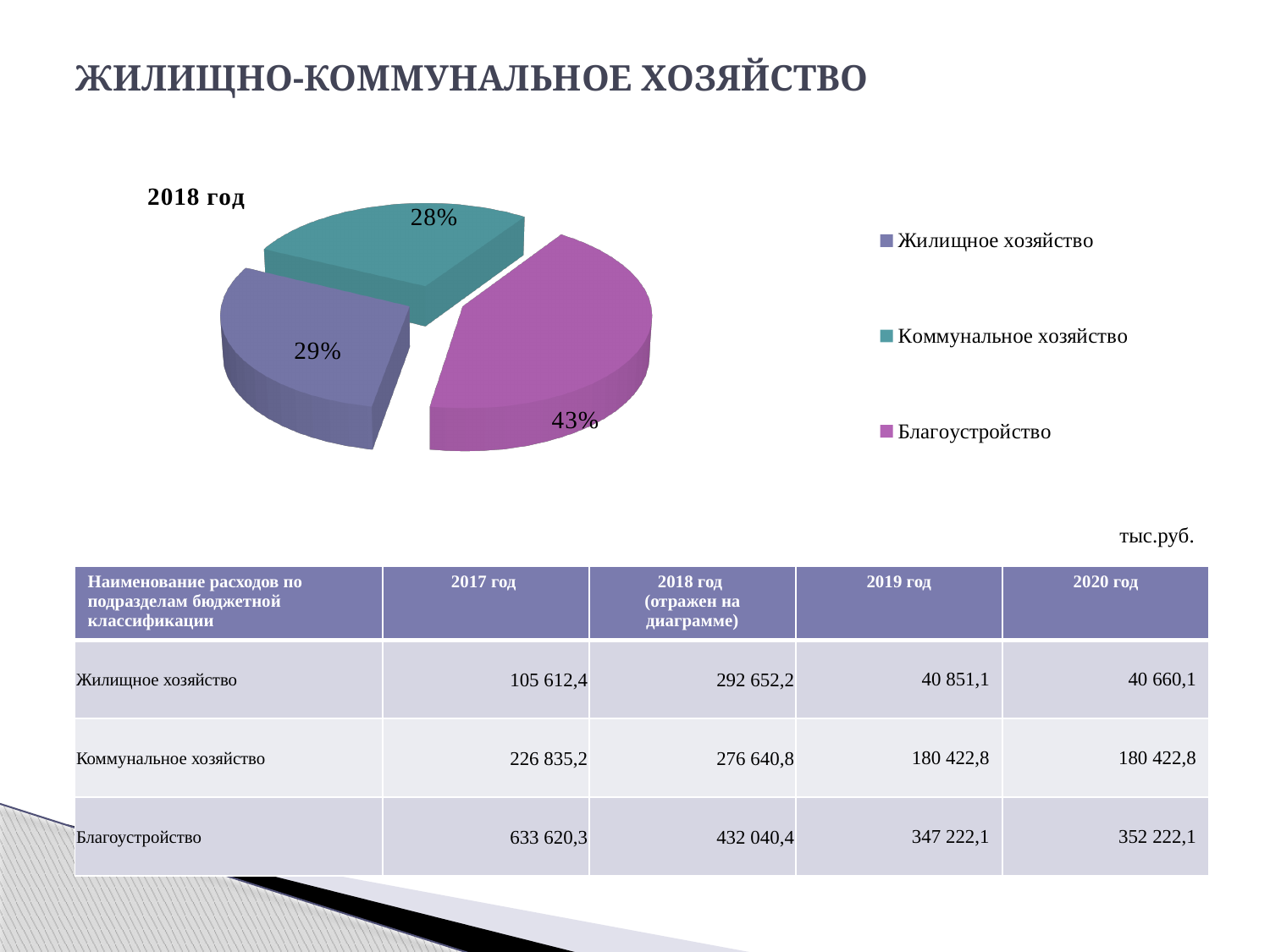
What share of the pie does Коммунальное хозяйство have? 28% What colour is the Благоустройство slice in the pie chart? Magenta (purple-pink) What kind of chart is shown on the slide? Pie chart Which category has the smallest slice of the pie? Коммунальное хозяйство What share of the pie does Жилищное хозяйство have? 29% How many entries does the legend list? 3 How many slices does the pie chart have? 3 Which year does the pie chart represent, according to its title? 2018 год What share of the pie does Благоустройство have? 43% What is the difference in percentage points between the Благоустройство slice and the Жилищное хозяйство slice? 14 Which slice is larger: Жилищное хозяйство or Коммунальное хозяйство? Жилищное хозяйство Which category has the largest slice of the pie? Благоустройство